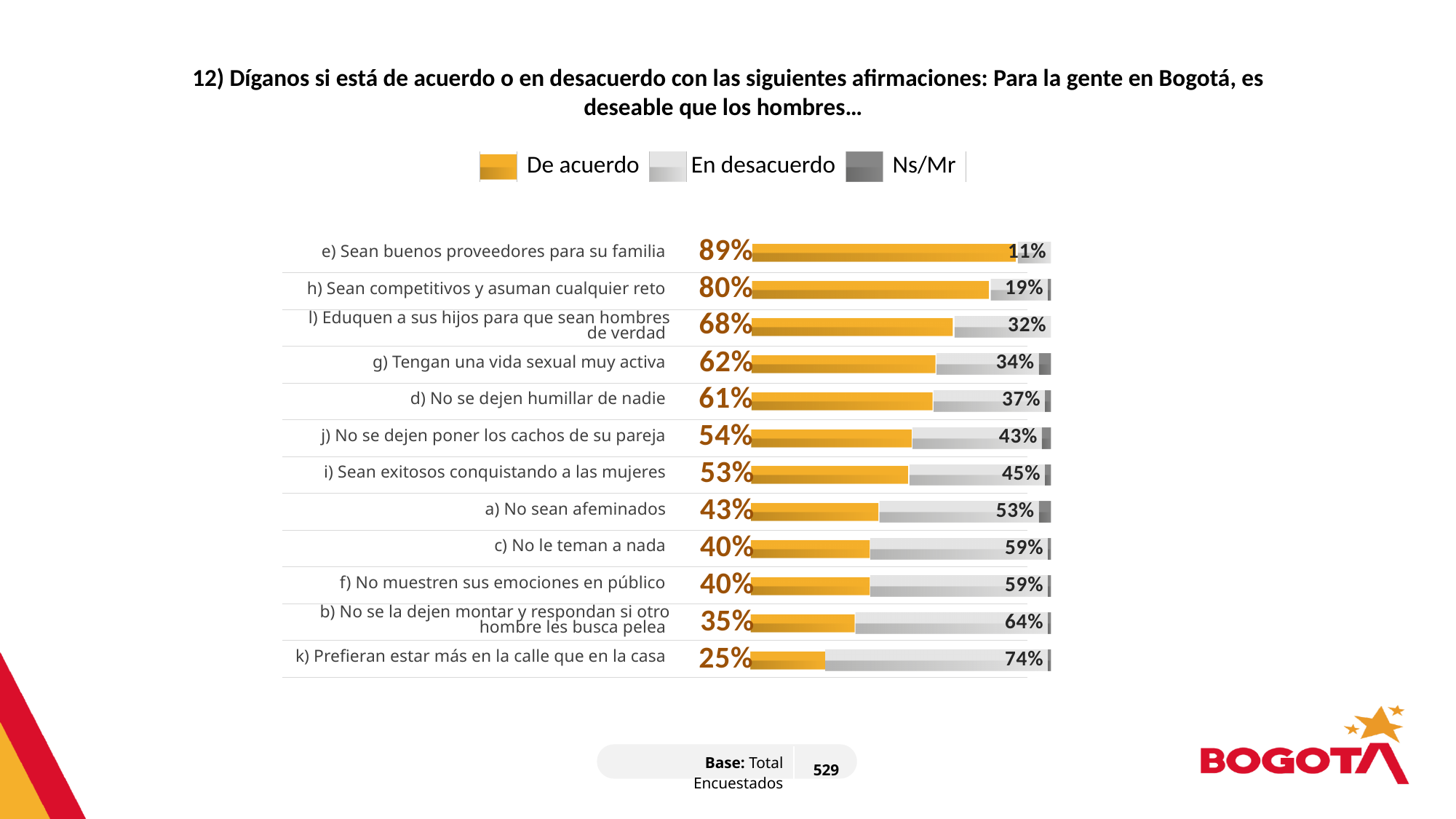
What is the 'De acuerdo' value for 'a) No sean afeminados'? 43% What is the 'En desacuerdo' value for 'k) Prefieran estar más en la calle que en la casa'? 74% What percentage of respondents agree (De acuerdo) that men should be good providers for their family (e)? 89% Which colour represents 'De acuerdo' in the legend? Orange/yellow How many statements are listed in the chart? 12 What is the 'En desacuerdo' value for 'l) Eduquen a sus hijos para que sean hombres de verdad'? 32% Which statement has the highest 'De acuerdo' percentage? e) Sean buenos proveedores para su familia What type of chart is shown on the slide? Stacked bar chart How many series does the legend list? 3 Which statement has the lowest 'De acuerdo' percentage? k) Prefieran estar más en la calle que en la casa Which has a higher 'En desacuerdo' value: 'c) No le teman a nada' or 'j) No se dejen poner los cachos de su pareja'? c) No le teman a nada What is the difference between the 'De acuerdo' values for 'h) Sean competitivos y asuman cualquier reto' and 'g) Tengan una vida sexual muy activa'? 18%